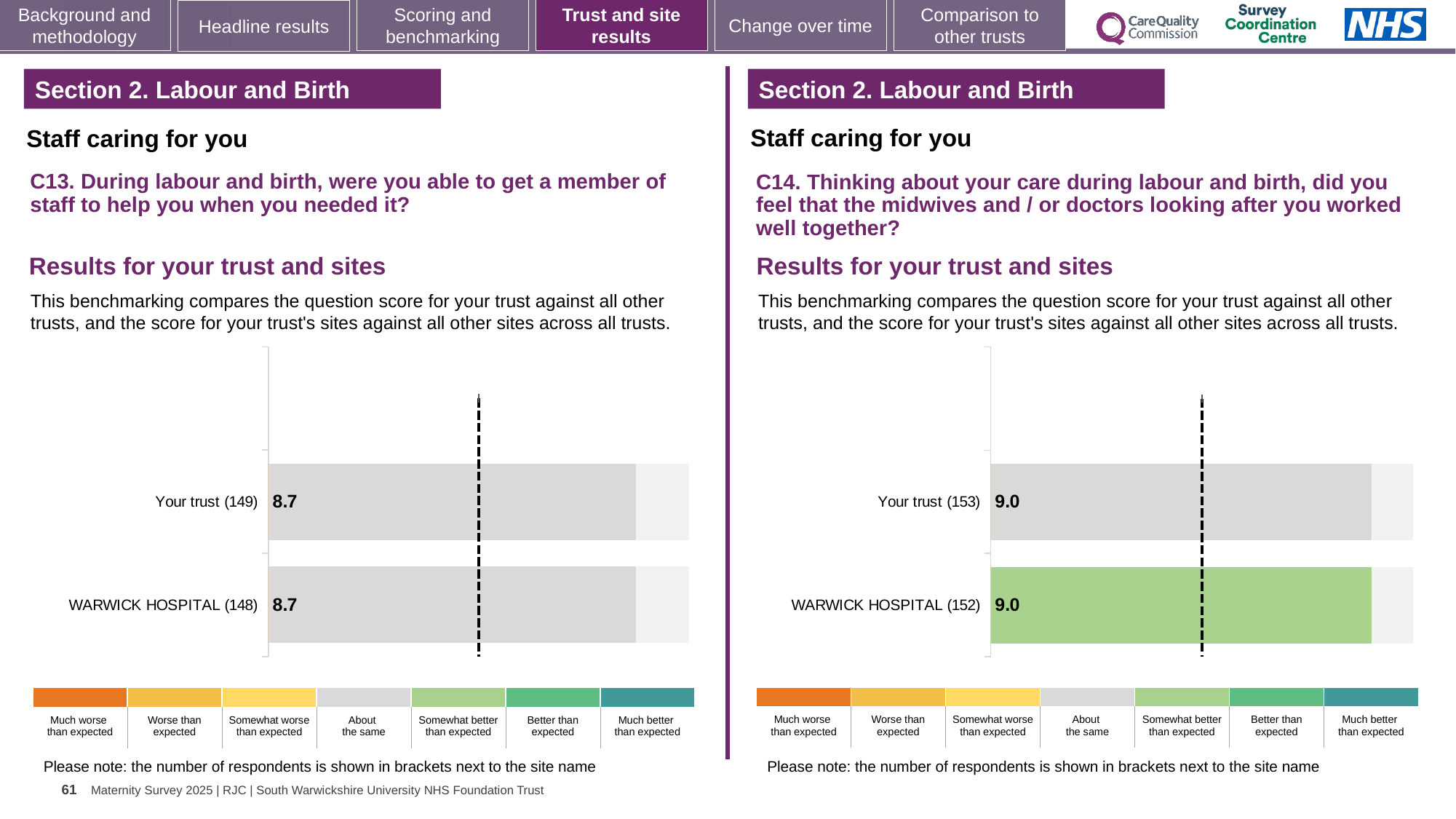
In the C13 chart on the left, how many respondents are shown in brackets for WARWICK HOSPITAL? 148 In the C13 chart on the left, what is the score for WARWICK HOSPITAL? 8.7 How many bars are plotted in the C14 chart on the right? 2 In the C14 chart on the right, what is the score for Your trust? 9.0 In the C14 chart on the right, what is the difference between the score for WARWICK HOSPITAL and the score for Your trust? 0.0 In the C14 chart on the right, what is the score for WARWICK HOSPITAL? 9.0 In the C13 chart on the left, what is the score for Your trust? 8.7 How many bars are plotted in the C13 chart on the left? 2 In the C14 chart on the right, which benchmarking category does the green colour of the WARWICK HOSPITAL bar represent according to the legend? Somewhat better than expected What kind of chart is used in the C13 chart on the left? Bar chart In the C13 chart on the left, what is the difference between the score for Your trust and the score for WARWICK HOSPITAL? 0.0 In the C14 chart on the right, how many respondents are shown in brackets for Your trust? 153